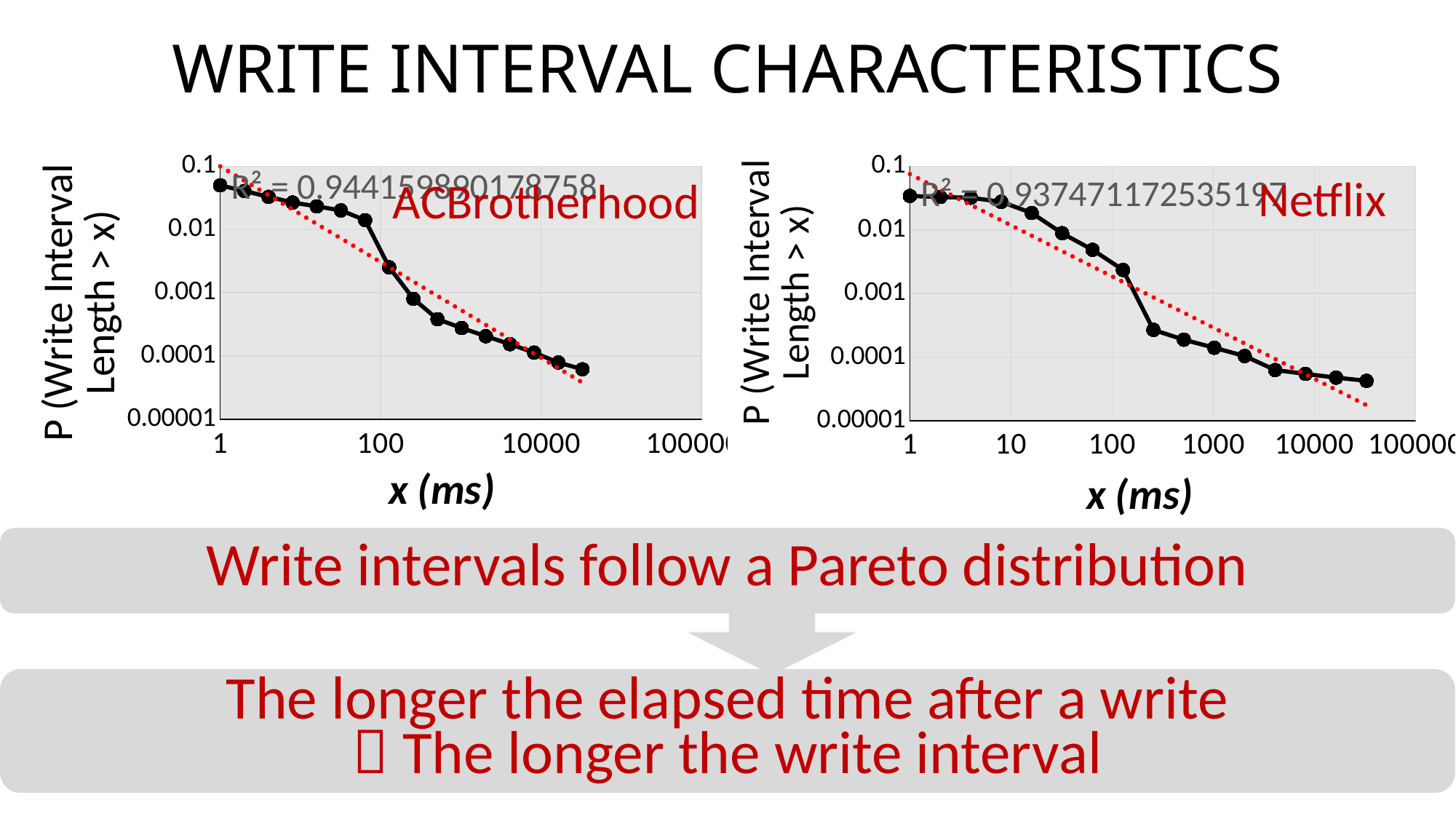
In the Netflix chart, is the value at x = 10000 ms greater or less than 0.0001? less What kind of chart is the ACBrotherhood chart? line chart In the Netflix chart, do the plotted values rise or fall as x (ms) increases? fall What R² value is printed on the Netflix chart? 0.937471172535197 In the Netflix chart, is the value at x = 100 ms greater or less than 0.001? greater In the ACBrotherhood chart, is the value at x = 1 ms greater or less than 0.01? greater In the ACBrotherhood chart, which has the larger value: the point at x = 1 ms or the point at x = 10000 ms? x = 1 ms In the ACBrotherhood chart, do the plotted values rise or fall as x (ms) increases? fall What R² value is printed on the ACBrotherhood chart? 0.944159890178758